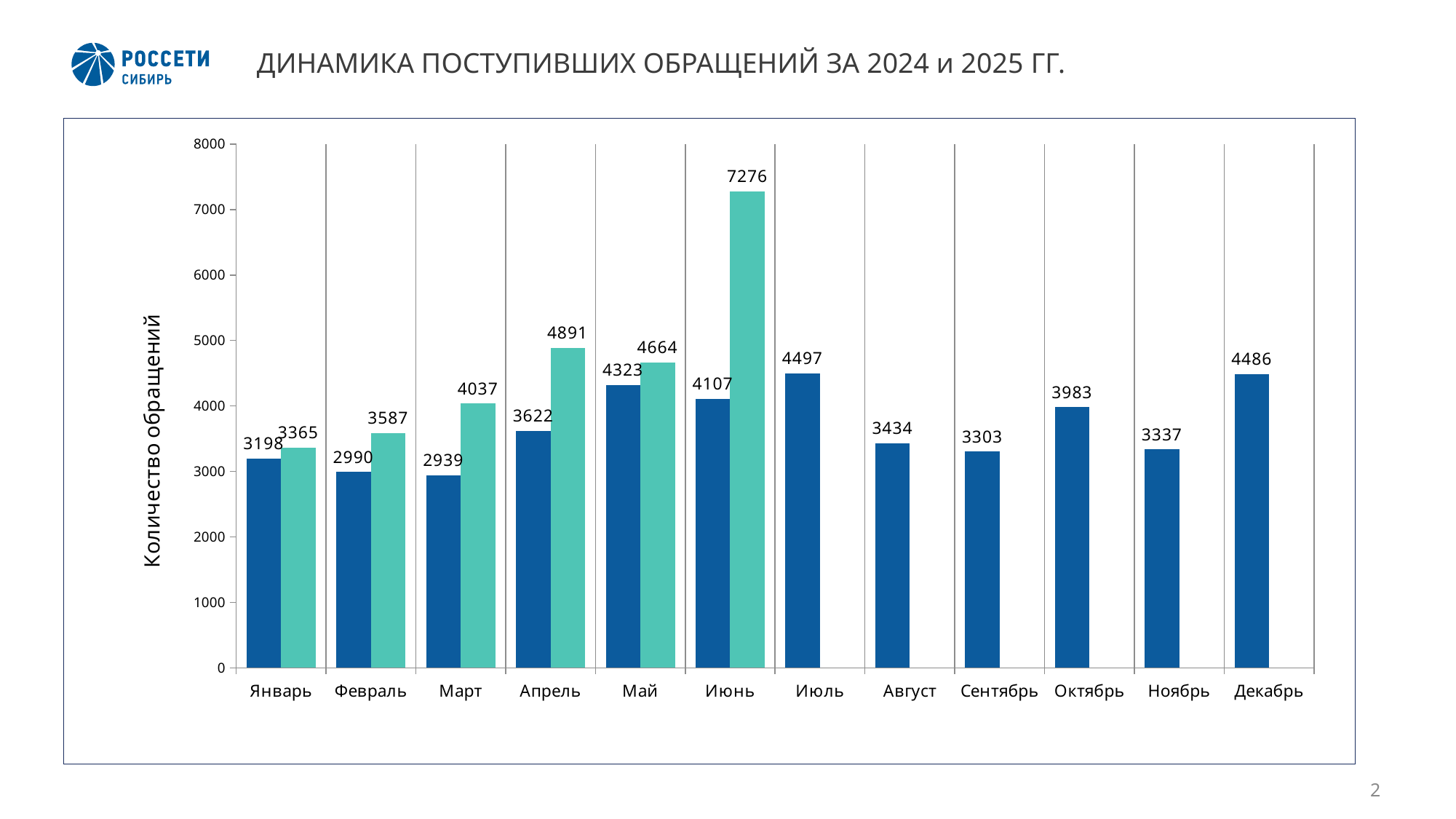
Which is larger for Май: the dark blue bar or the teal bar? The teal bar What type of chart is shown on the slide? Bar chart How many months are shown on the x axis? 12 Which month has the highest teal bar? Июнь Which month has the lowest dark blue bar? Март What is the value of the teal bar for Июнь? 7276 How many months have a teal bar? 6 What is the value of the dark blue bar for Декабрь? 4486 What is the difference between the teal bar and the dark blue bar for Апрель? 1269 What is the value of the dark blue bar for Январь? 3198 What is the label of the vertical axis? Количество обращений What is the difference between the teal bar and the dark blue bar for Июнь? 3169